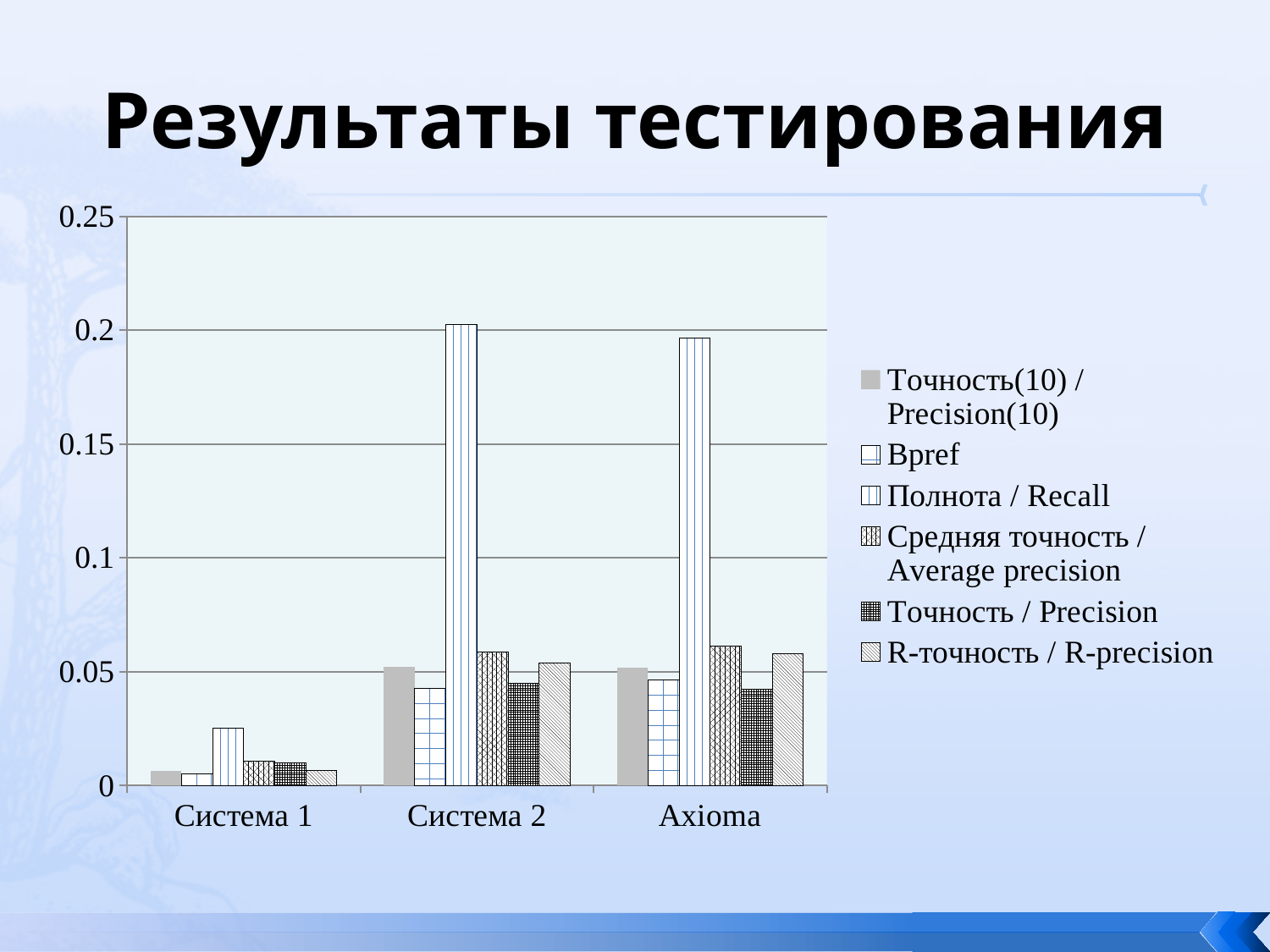
Is the value of Полнота / Recall for Система 2 greater or less than 0.15? greater How many series does the chart's legend list? 6 Which is larger for Полнота / Recall: Система 1 or Axioma? Axioma Which series has the highest value for Axioma? Полнота / Recall How many categories are shown on the x axis of the chart? 3 Which category has the lowest value for Полнота / Recall? Система 1 What kind of chart is shown on the slide? bar chart Which is larger for Система 2: Полнота / Recall or Точность(10) / Precision(10)? Полнота / Recall Is the value of Полнота / Recall for Система 1 greater or less than 0.05? less What is the title of the slide containing the chart? Результаты тестирования Is the value of Средняя точность / Average precision for Axioma greater or less than 0.1? less Which series has the highest value for Система 2? Полнота / Recall